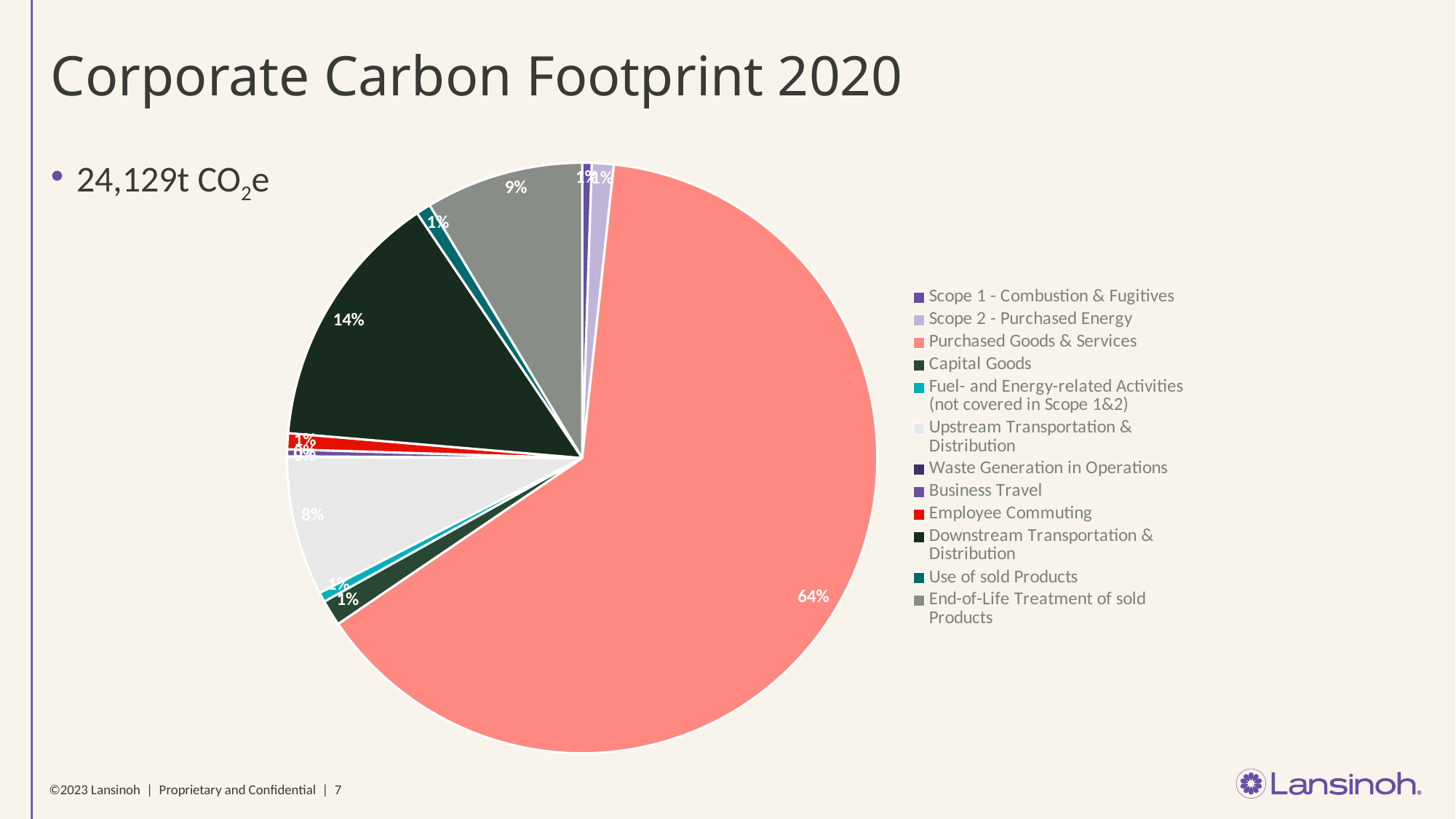
What is the difference in percentage points between the Purchased Goods & Services slice and the Downstream Transportation & Distribution slice? 50% What share of the pie does End-of-Life Treatment of sold Products account for? 9% What share of the pie does Purchased Goods & Services account for? 64% What colour is the slice for Employee Commuting? red What kind of chart is shown on the slide? pie chart Which is larger, the slice for End-of-Life Treatment of sold Products or the slice for Upstream Transportation & Distribution? End-of-Life Treatment of sold Products What is the title of the slide containing the pie chart? Corporate Carbon Footprint 2020 What share of the pie does Upstream Transportation & Distribution account for? 8% How many categories does the legend list? 12 Which category has the largest slice of the pie? Purchased Goods & Services